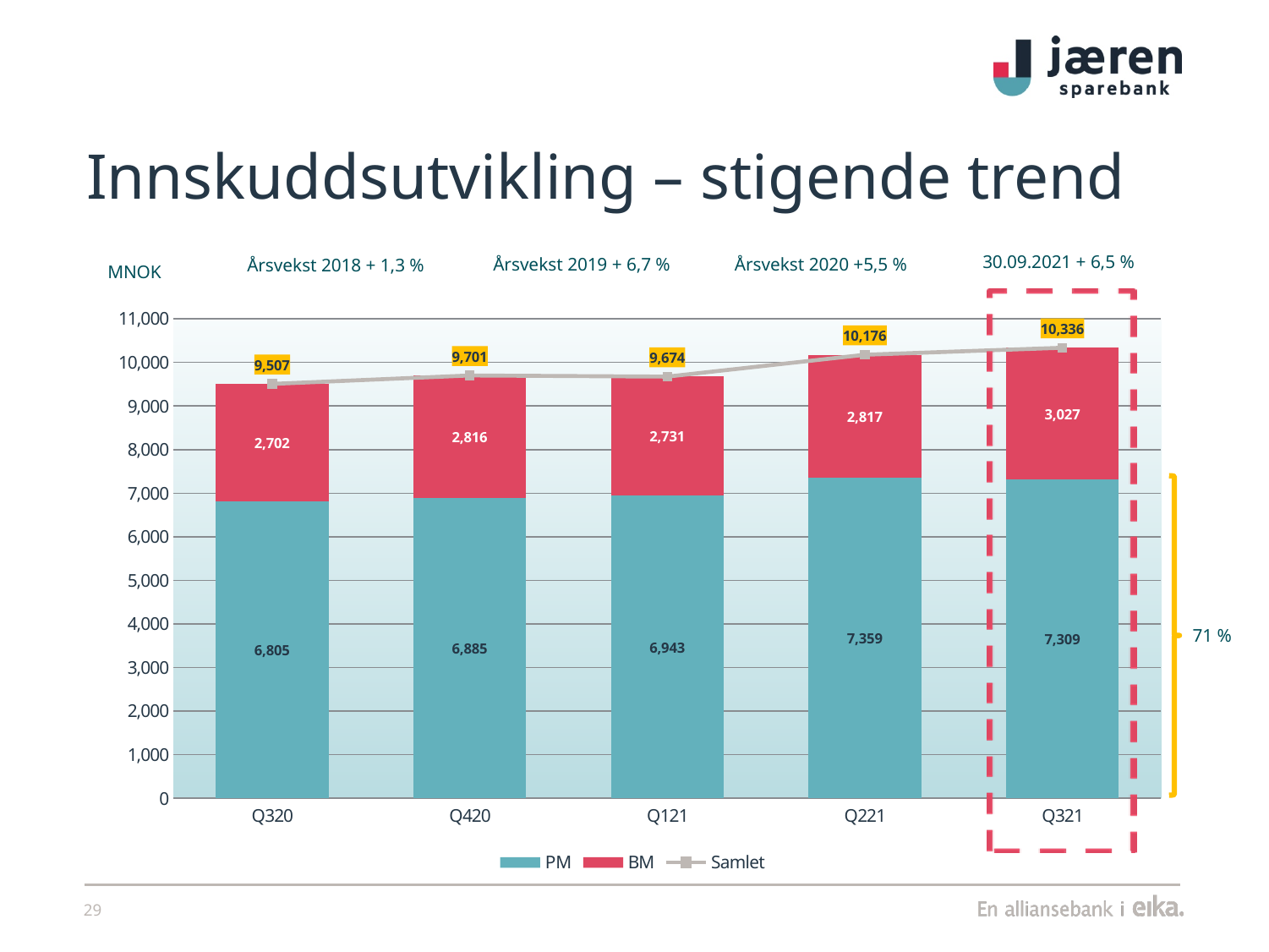
What is the BM value for Q321? 3,027 Does the Samlet value rise or fall from Q121 to Q321? Rise What is the PM value for Q221? 7,359 What is the title of the slide? Innskuddsutvikling – stigende trend What kind of chart is this? Stacked bar chart with a line What is the difference between the Samlet values for Q321 and Q320? 829 What is the Samlet value for Q420? 9,701 Which quarter has the highest Samlet value? Q321 How many quarters are shown on the x axis? 5 Which is larger, the BM value for Q420 or the BM value for Q121? Q420 Which quarter has the lowest PM value? Q320 How many series does the legend list? 3